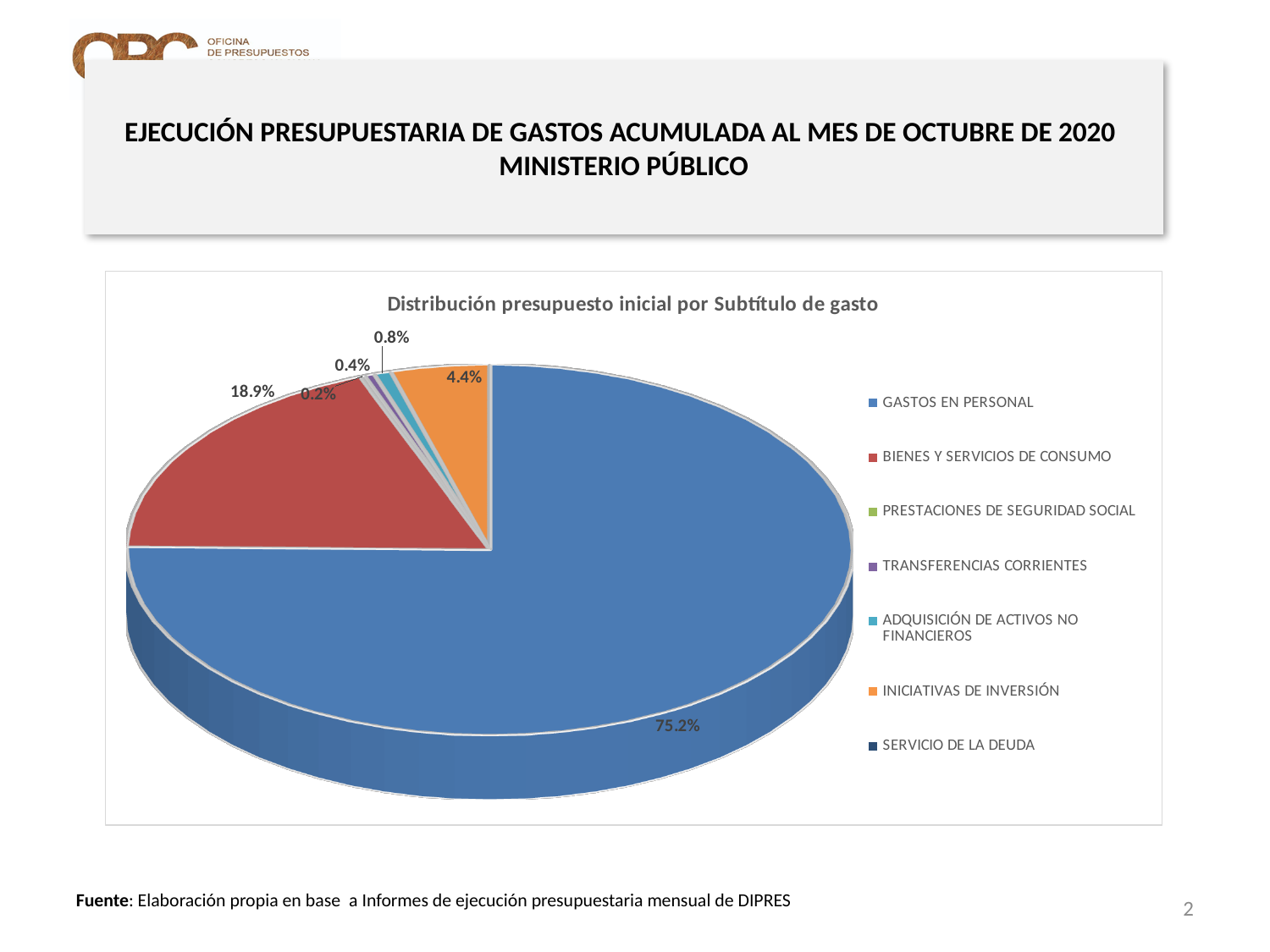
Which category has the largest share of the pie? GASTOS EN PERSONAL What share of the pie does TRANSFERENCIAS CORRIENTES represent? 0.4% What is the title of the chart? Distribución presupuesto inicial por Subtítulo de gasto What share of the pie does INICIATIVAS DE INVERSIÓN represent? 4.4% What share of the pie does BIENES Y SERVICIOS DE CONSUMO represent? 18.9% How many categories does the chart's legend list? 7 What is the difference in percentage points between GASTOS EN PERSONAL and BIENES Y SERVICIOS DE CONSUMO? 56.3 What colour is the slice for GASTOS EN PERSONAL? Blue What kind of chart is shown on the slide? Pie chart Which has a larger share, BIENES Y SERVICIOS DE CONSUMO or INICIATIVAS DE INVERSIÓN? BIENES Y SERVICIOS DE CONSUMO